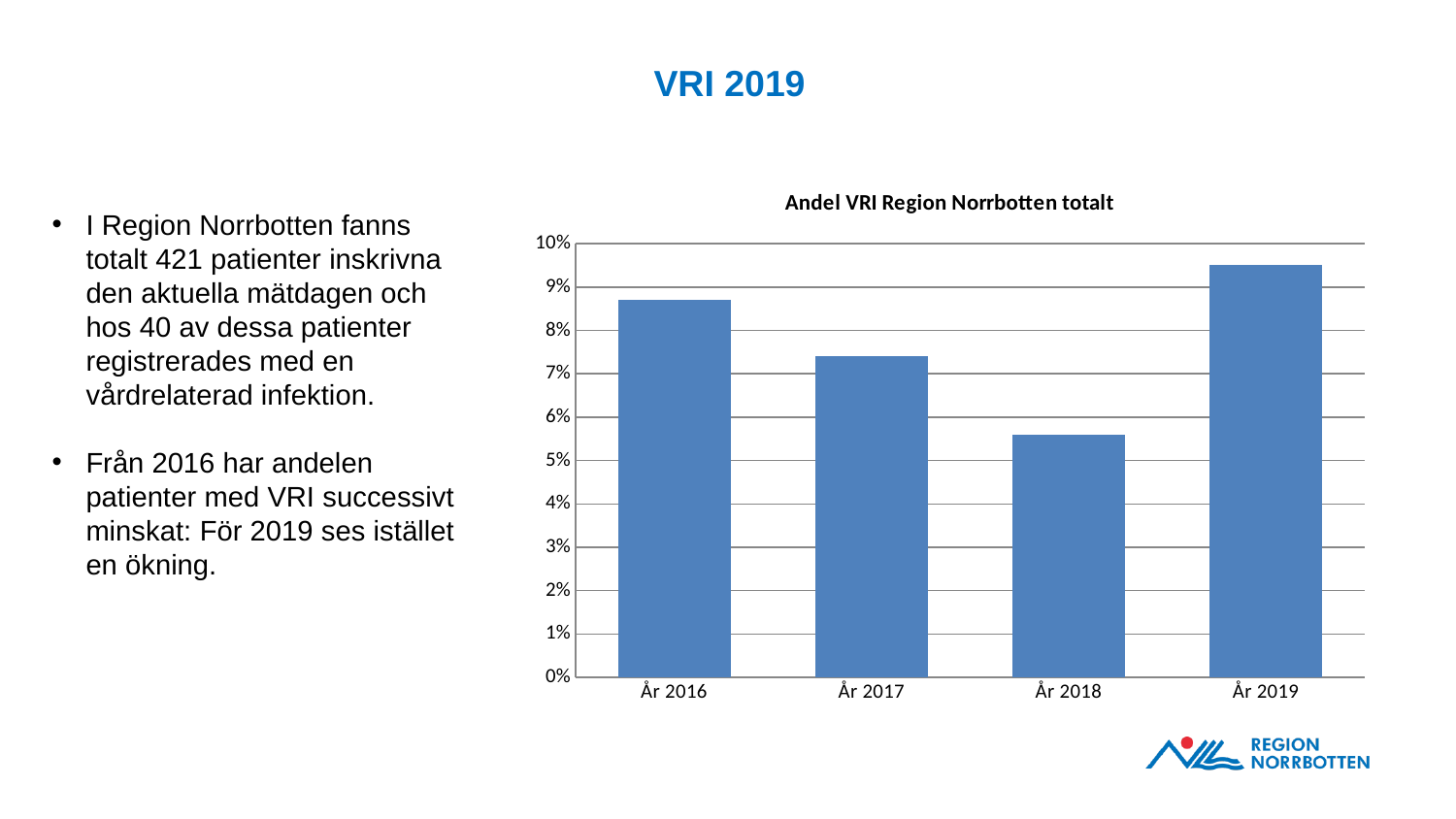
Is the value for År 2016 greater or less than 8%? greater How do the values change from År 2016 to År 2018 in the chart? they fall Which year has the highest value in the chart? År 2019 Is the value for År 2017 greater or less than 8%? less How many years (categories) are shown on the x axis of the chart? 4 Which is larger, the value for År 2018 or the value for År 2019? År 2019 Which is larger, the value for År 2016 or the value for År 2017? År 2016 Is the value for År 2019 greater or less than 9%? greater Which year has the lowest value in the chart? År 2018 What is the title of the chart? Andel VRI Region Norrbotten totalt What kind of chart is shown on the slide? bar chart